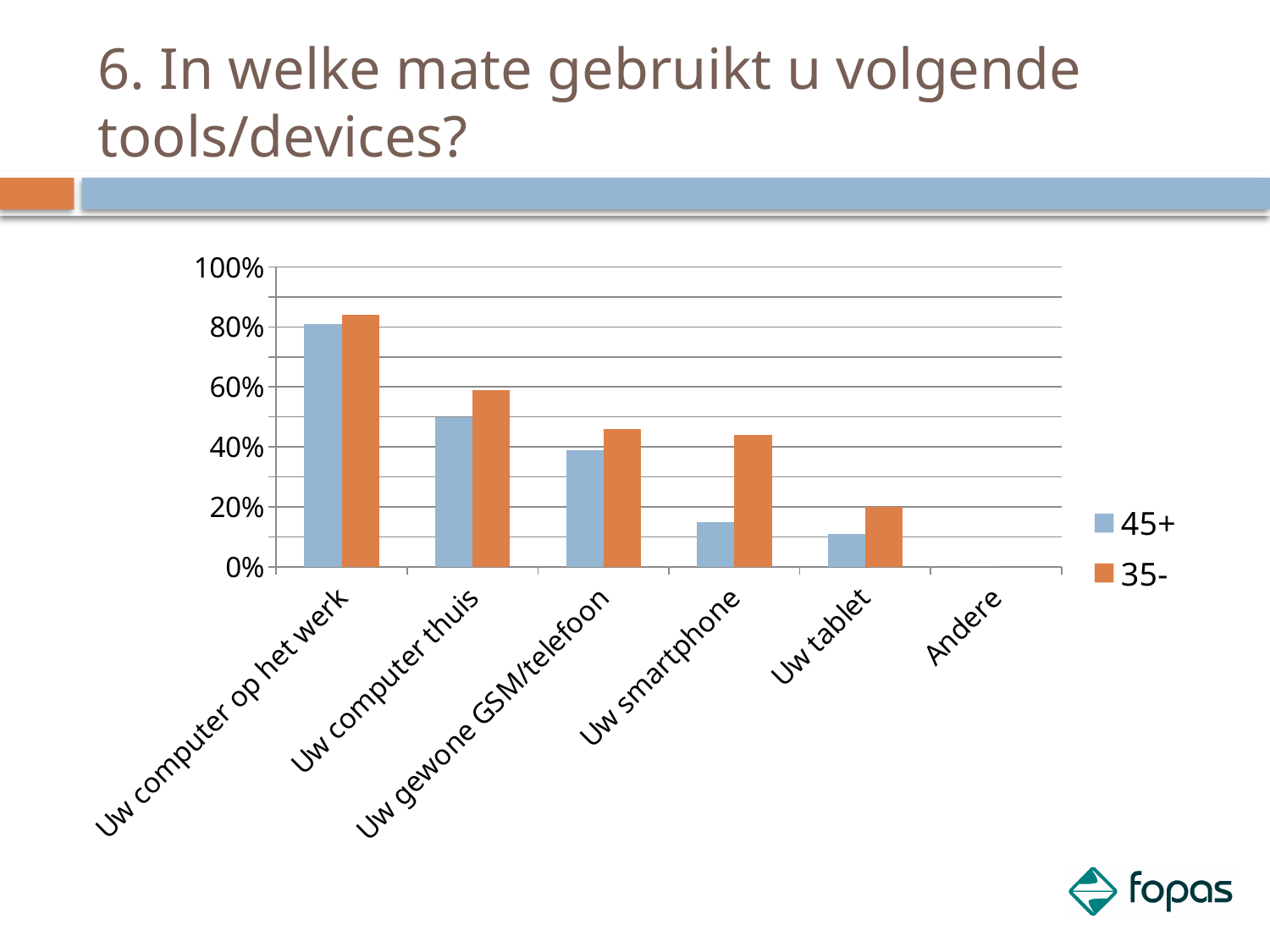
Which category has the highest value for the 35- series? Uw computer op het werk What kind of chart is shown on the slide? bar chart How many categories are shown on the x axis? 6 What are the two entries listed in the legend? 45+ and 35- Which category has the highest value for the 45+ series? Uw computer op het werk Is the value for Uw smartphone in the 35- series greater or less than 40%? greater Is the value for Uw smartphone in the 45+ series greater or less than 20%? less Which is larger for Uw smartphone: the 45+ value or the 35- value? 35- Do the values for the 35- series rise or fall from left to right along the x axis? fall Which category has the lowest value for the 45+ series? Andere How many series does the legend list? 2